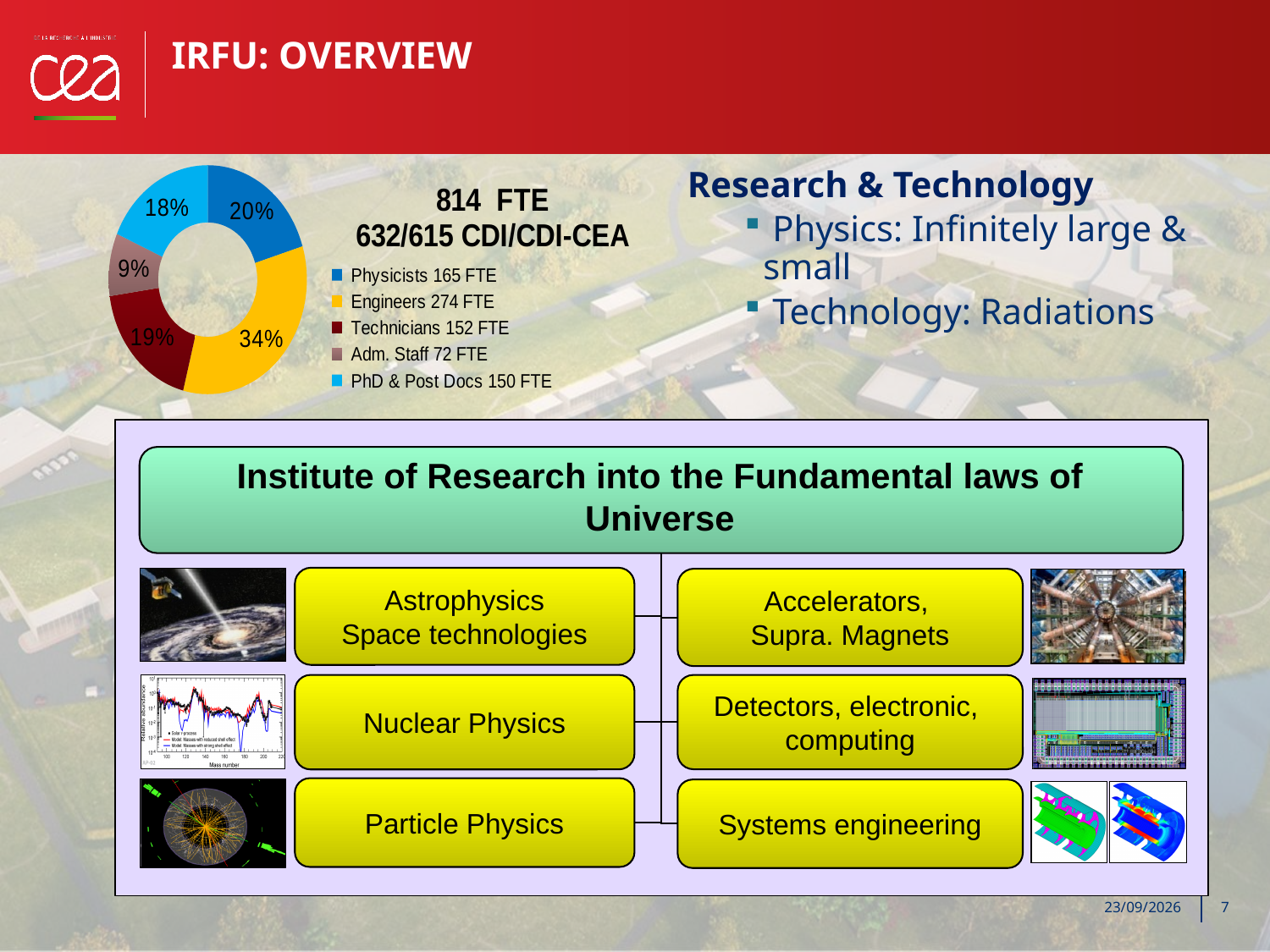
What share of the doughnut chart do Engineers represent? 34% According to the legend, how many FTE are Engineers? 274 FTE Which category has the smallest slice in the doughnut chart? Adm. Staff What kind of chart is shown on the slide? Doughnut chart What share of the doughnut chart do PhD & Post Docs represent? 18% Which category has the largest slice in the doughnut chart? Engineers What share of the doughnut chart does Adm. Staff represent? 9% Which slice is larger, Technicians or PhD & Post Docs? Technicians By how many percentage points does the Engineers share exceed the Physicists share? 14 percentage points How many categories does the doughnut chart show? 5